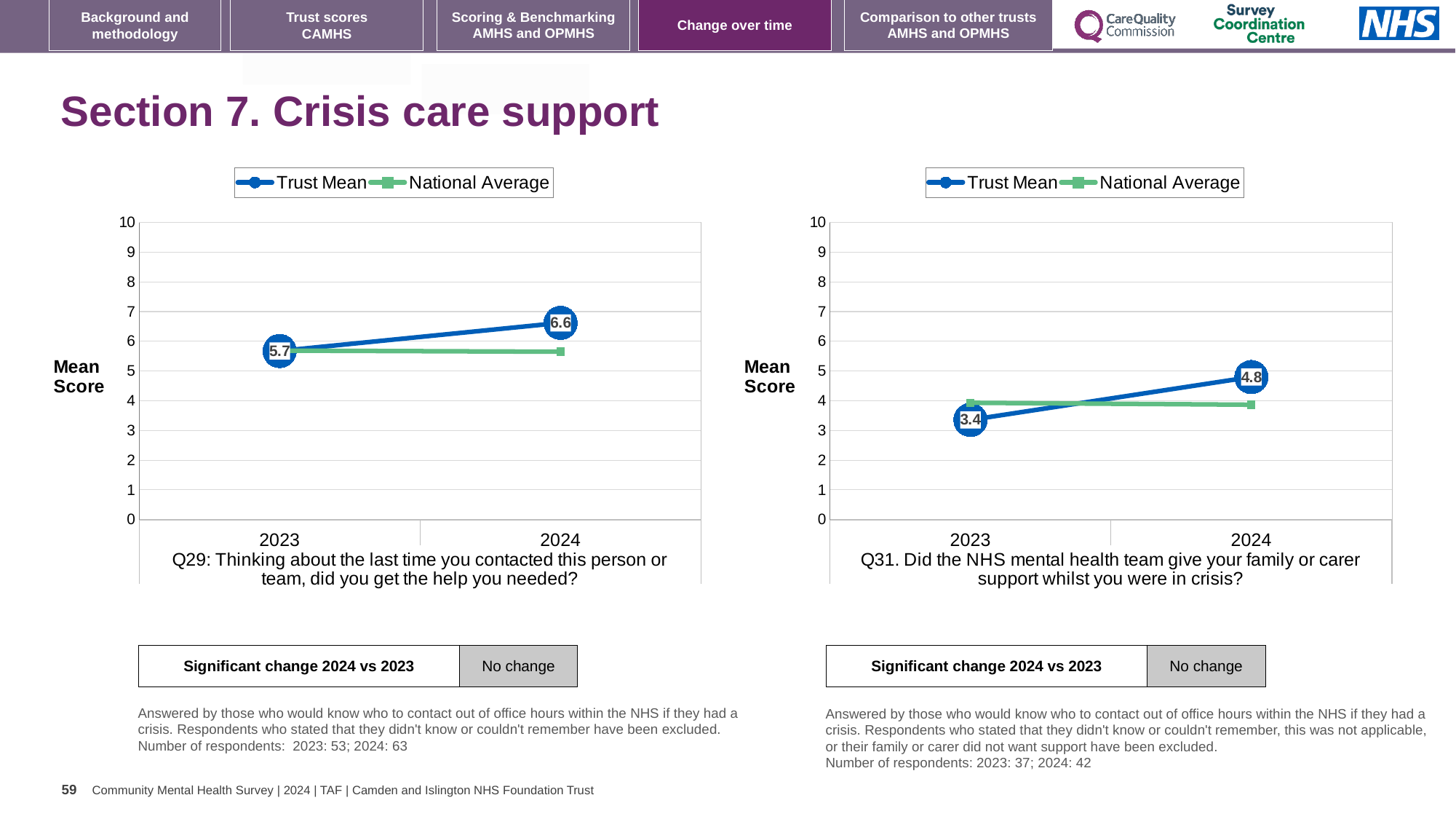
In the Q31 chart on the right, is the National Average value for 2023 greater or less than 3? greater In the Q29 chart on the left, by how much did the Trust Mean change from 2023 to 2024? 0.9 In the Q31 chart on the right, by how much did the Trust Mean change from 2023 to 2024? 1.4 In the Q29 chart on the left, what is the Trust Mean score for 2024? 6.6 In the Q31 chart on the right, what is the Trust Mean score for 2023? 3.4 How many years are shown on the x axis of the Q29 chart on the left? 2 What kind of chart is the Q29 chart on the left? line chart In the Q31 chart on the right, which is larger in 2024, the Trust Mean or the National Average? Trust Mean In the Q31 chart on the right, does the Trust Mean rise or fall from 2023 to 2024? rise How many series does the legend of the Q31 chart on the right list? 2 In the Q31 chart on the right, what is the Trust Mean score for 2024? 4.8 In the Q29 chart on the left, what is the Trust Mean score for 2023? 5.7